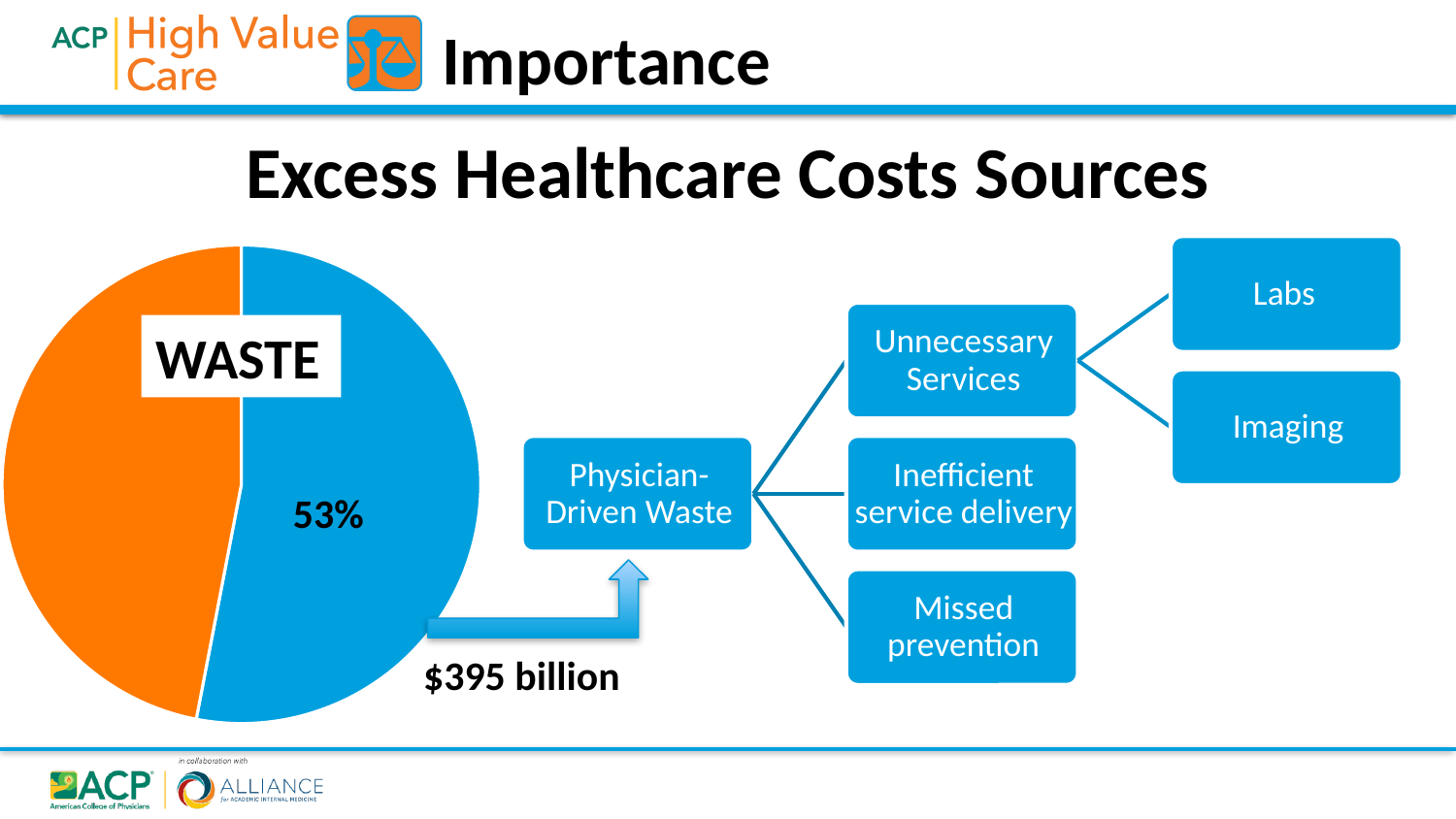
What percentage is printed on the blue slice of the pie chart? 53% What share of the pie does the blue slice represent? 53% What is the title above the chart? Excess Healthcare Costs Sources Is the blue slice of the pie greater or less than 50%? greater What kind of chart is shown on the slide? pie chart What two colours are used for the slices of the pie chart? blue and orange How many slices does the pie chart have? 2 Which slice of the pie is larger, the blue slice or the orange slice? the blue slice What dollar amount is printed next to the arrow leading from the pie chart to the Physician-Driven Waste box? $395 billion